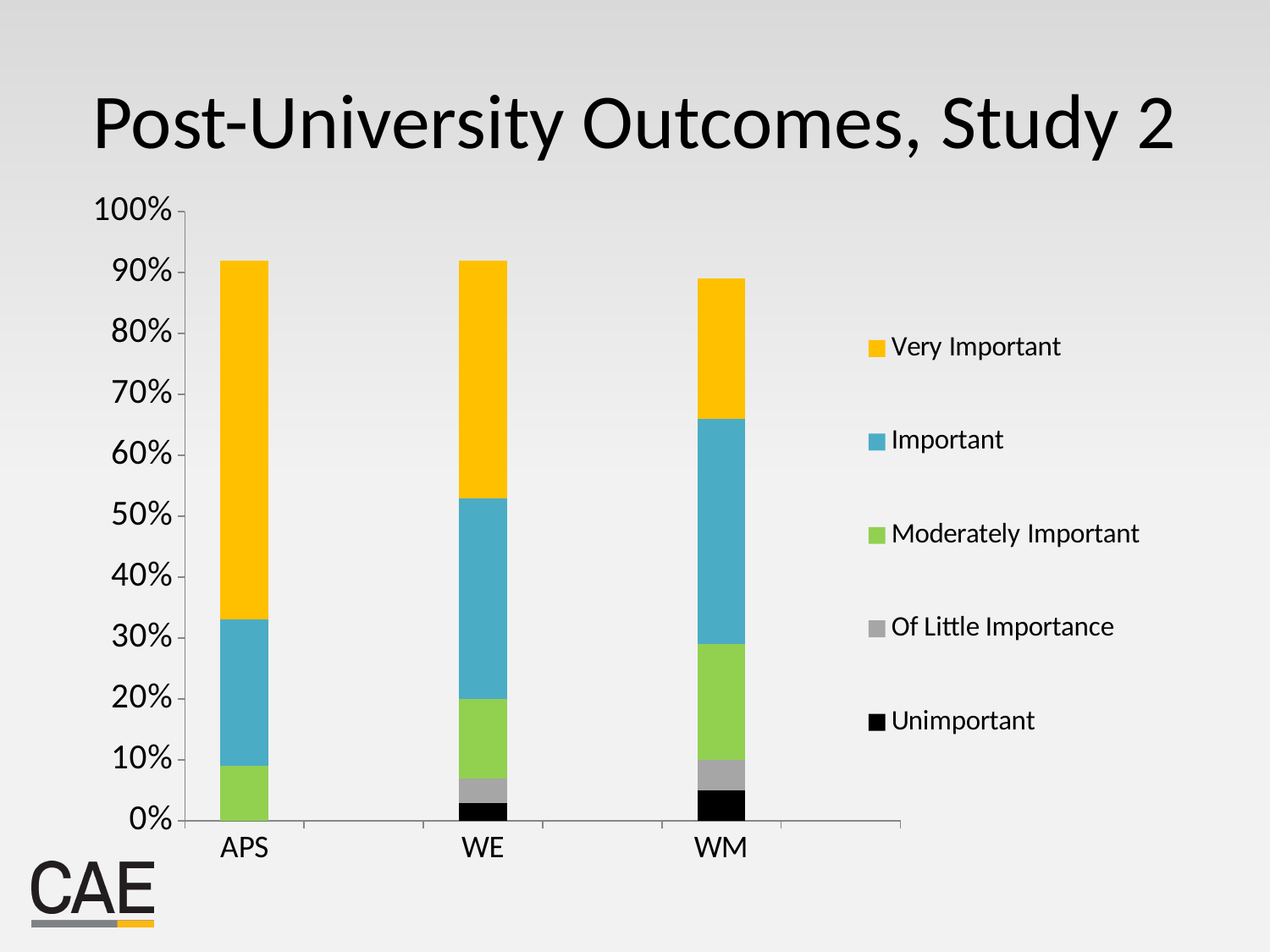
Which category has the smallest Important segment? APS Which category has the largest Very Important segment? APS How many categories are shown on the x axis? 3 What kind of chart is shown on the slide? stacked bar chart What is the title of the chart? Post-University Outcomes, Study 2 Is the top of the Important segment for WM greater or less than 60%? greater Is the total height of the WM bar greater or less than 80%? greater Which colour represents the Very Important series? yellow How many series does the legend list? 5 Is the Very Important segment larger for APS or for WM? APS Which category has the largest Moderately Important segment? WM Is the top of the Important segment for APS greater or less than 40%? less